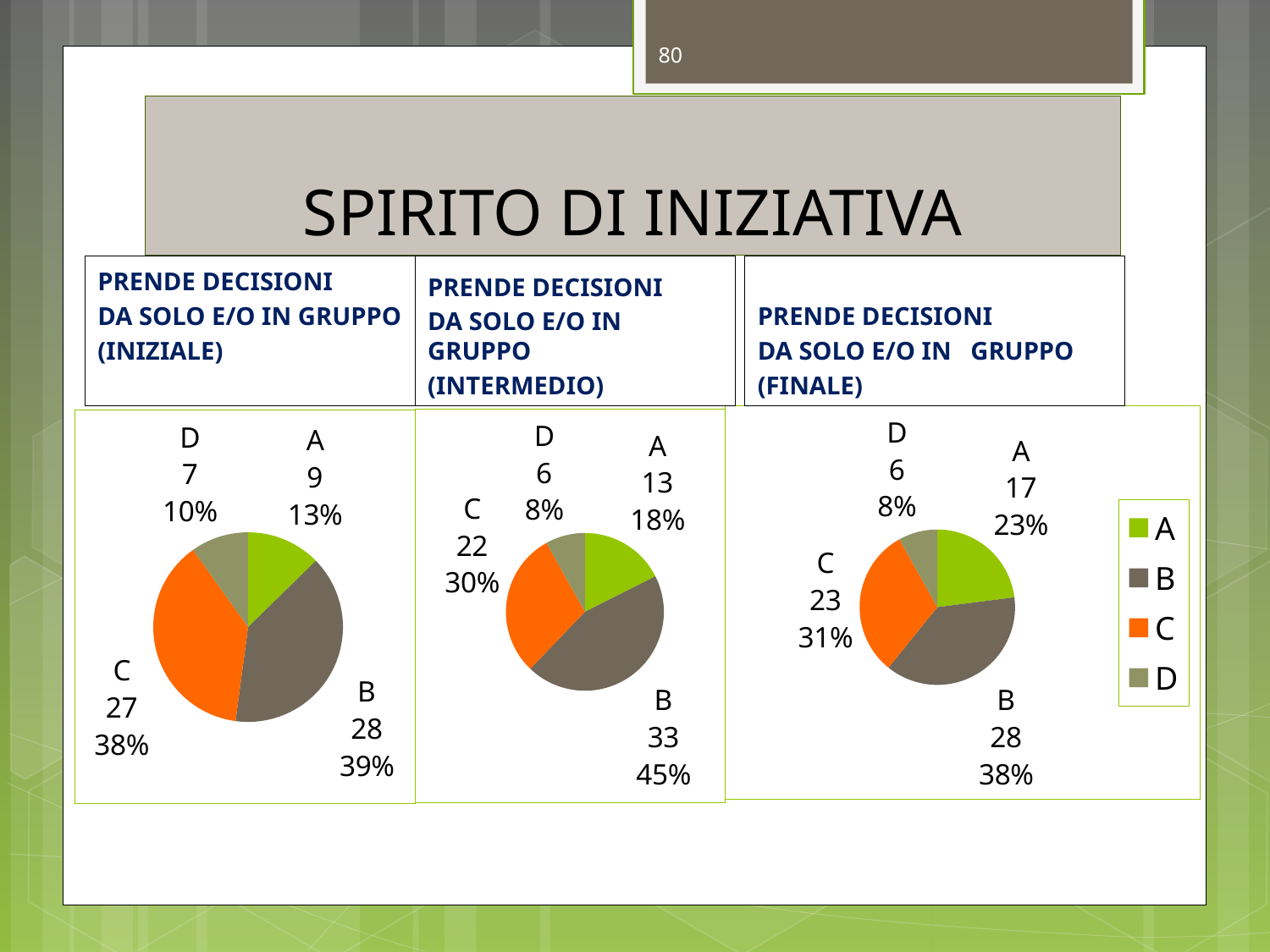
In the INIZIALE pie chart, what is the value for category B? 28 In the INIZIALE pie chart, what percentage share does category C have? 38% In the FINALE pie chart, what percentage share does category A have? 23% In the INTERMEDIO pie chart, which category has the largest slice? B In the INTERMEDIO pie chart, what is the value for category A? 13 Which colour represents category C in the legend? Orange In the INTERMEDIO pie chart, which category has the smallest slice? D In the INTERMEDIO pie chart, which is larger, the value for C or the value for A? C How many categories does the INIZIALE pie chart show? 4 In the FINALE pie chart, what is the value for category C? 23 In the FINALE pie chart, what is the difference between the values for B and A? 11 What type of chart is used for the FINALE data? Pie chart